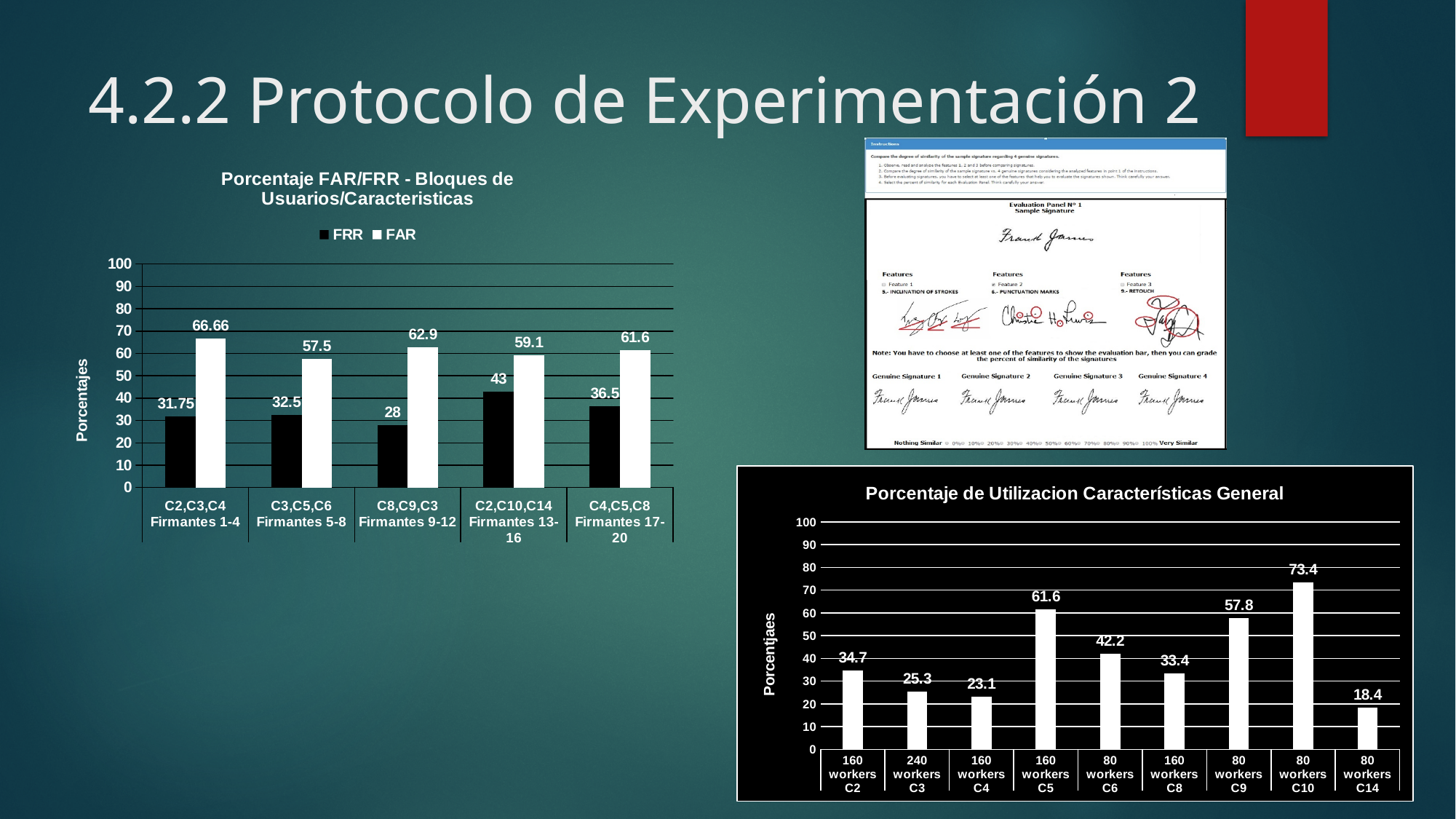
What kind of chart is the 'Porcentaje de Utilizacion Características General' chart? Bar chart In the 'Porcentaje de Utilizacion Características General' chart, which is larger: the value for 160 workers C5 or the value for 80 workers C9? 160 workers C5 In the 'Porcentaje de Utilizacion Características General' chart, what is the difference between the values for 80 workers C10 and 80 workers C14? 55 In the 'Porcentaje FAR/FRR - Bloques de Usuarios/Caracteristicas' chart, what is the FAR value for C2,C3,C4 Firmantes 1-4? 66.66 In the 'Porcentaje FAR/FRR - Bloques de Usuarios/Caracteristicas' chart, how many categories are shown on the x axis? 5 In the 'Porcentaje FAR/FRR - Bloques de Usuarios/Caracteristicas' chart, how many series does the legend list? 2 In the 'Porcentaje de Utilizacion Características General' chart, what is the value for 80 workers C10? 73.4 In the 'Porcentaje FAR/FRR - Bloques de Usuarios/Caracteristicas' chart, what is the difference between the FAR and FRR values for C3,C5,C6 Firmantes 5-8? 25 In the 'Porcentaje FAR/FRR - Bloques de Usuarios/Caracteristicas' chart, what is the FRR value for C2,C10,C14 Firmantes 13-16? 43 In the 'Porcentaje FAR/FRR - Bloques de Usuarios/Caracteristicas' chart, which category has the lowest FRR value? C8,C9,C3 Firmantes 9-12 In the 'Porcentaje de Utilizacion Características General' chart, how many bars are plotted? 9 In the 'Porcentaje de Utilizacion Características General' chart, which category has the lowest value? 80 workers C14